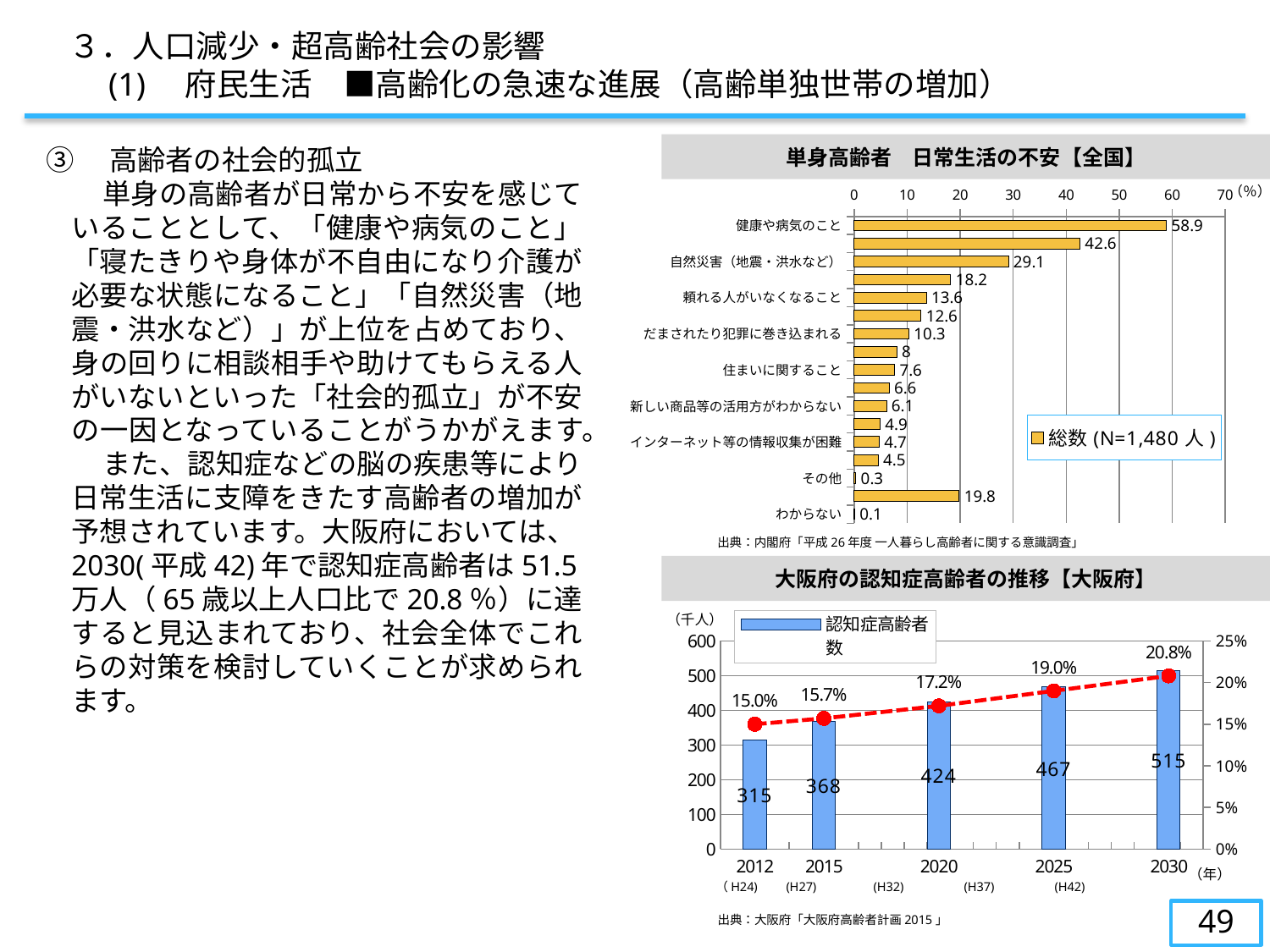
In the chart titled 「単身高齢者 日常生活の不安【全国】」, what is the legend entry? 総数 (N=1,480 人) In the chart titled 「大阪府の認知症高齢者の推移【大阪府】」, what is the bar value for 2030? 515 In the chart titled 「大阪府の認知症高齢者の推移【大阪府】」, what is the difference between the bar values for 2030 and 2012? 200 In the chart titled 「大阪府の認知症高齢者の推移【大阪府】」, which year has the lowest percentage value? 2012 In the chart titled 「単身高齢者 日常生活の不安【全国】」, what is the value for 自然災害（地震・洪水など）? 29.1 In the chart titled 「大阪府の認知症高齢者の推移【大阪府】」, what percentage is shown for 2025? 19.0% In the chart titled 「単身高齢者 日常生活の不安【全国】」, what is the value for 健康や病気のこと? 58.9 In the chart titled 「大阪府の認知症高齢者の推移【大阪府】」, how many years are plotted? 5 In the chart titled 「単身高齢者 日常生活の不安【全国】」, what kind of chart is it? bar chart In the chart titled 「大阪府の認知症高齢者の推移【大阪府】」, what is the bar value for 2012? 315 In the chart titled 「大阪府の認知症高齢者の推移【大阪府】」, do the bar values rise or fall from 2012 to 2030? rise In the chart titled 「単身高齢者 日常生活の不安【全国】」, which category has the highest value? 健康や病気のこと